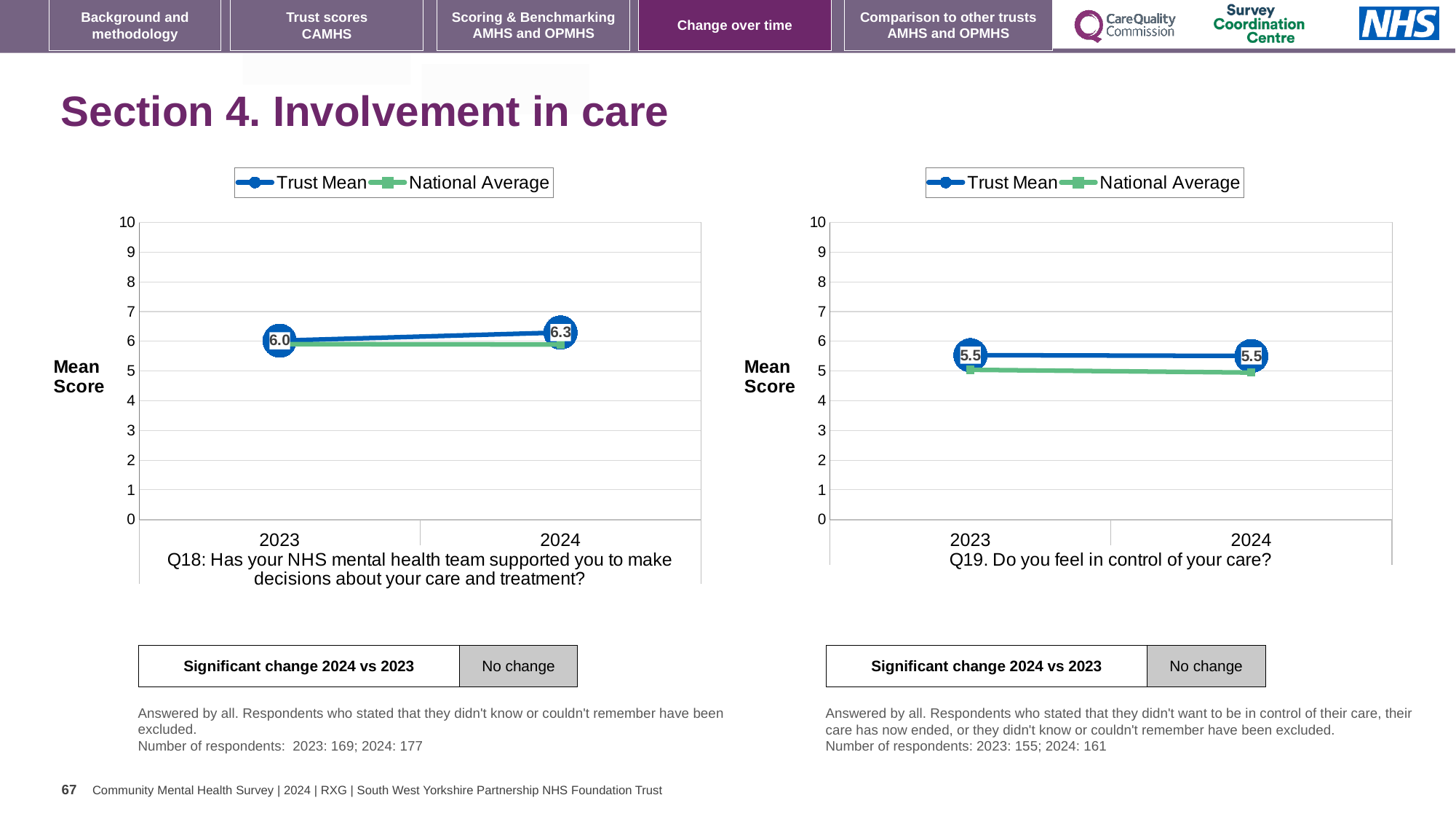
In the Q18 chart on the left, does the Trust Mean rise or fall from 2023 to 2024? rise In the Q19 chart on the right, which is higher in 2023: the Trust Mean or the National Average? Trust Mean How many series does the legend of the Q18 chart on the left list? 2 In the Q19 chart on the right, is the National Average for 2024 greater or less than 6? less In the Q19 chart on the right, what is the Trust Mean score for 2024? 5.5 In the Q18 chart on the left, by how much did the Trust Mean change from 2023 to 2024? 0.3 In the Q18 chart on the left, what is the Trust Mean score for 2023? 6.0 In the Q19 chart on the right, does the Trust Mean rise, fall or stay the same from 2023 to 2024? stays the same What does the box below the Q18 chart on the left say about significant change 2024 vs 2023? No change What type of chart is used for Q19 on the right? line chart How many years are plotted on the x axis of the Q19 chart on the right? 2 In the Q18 chart on the left, what is the Trust Mean score for 2024? 6.3